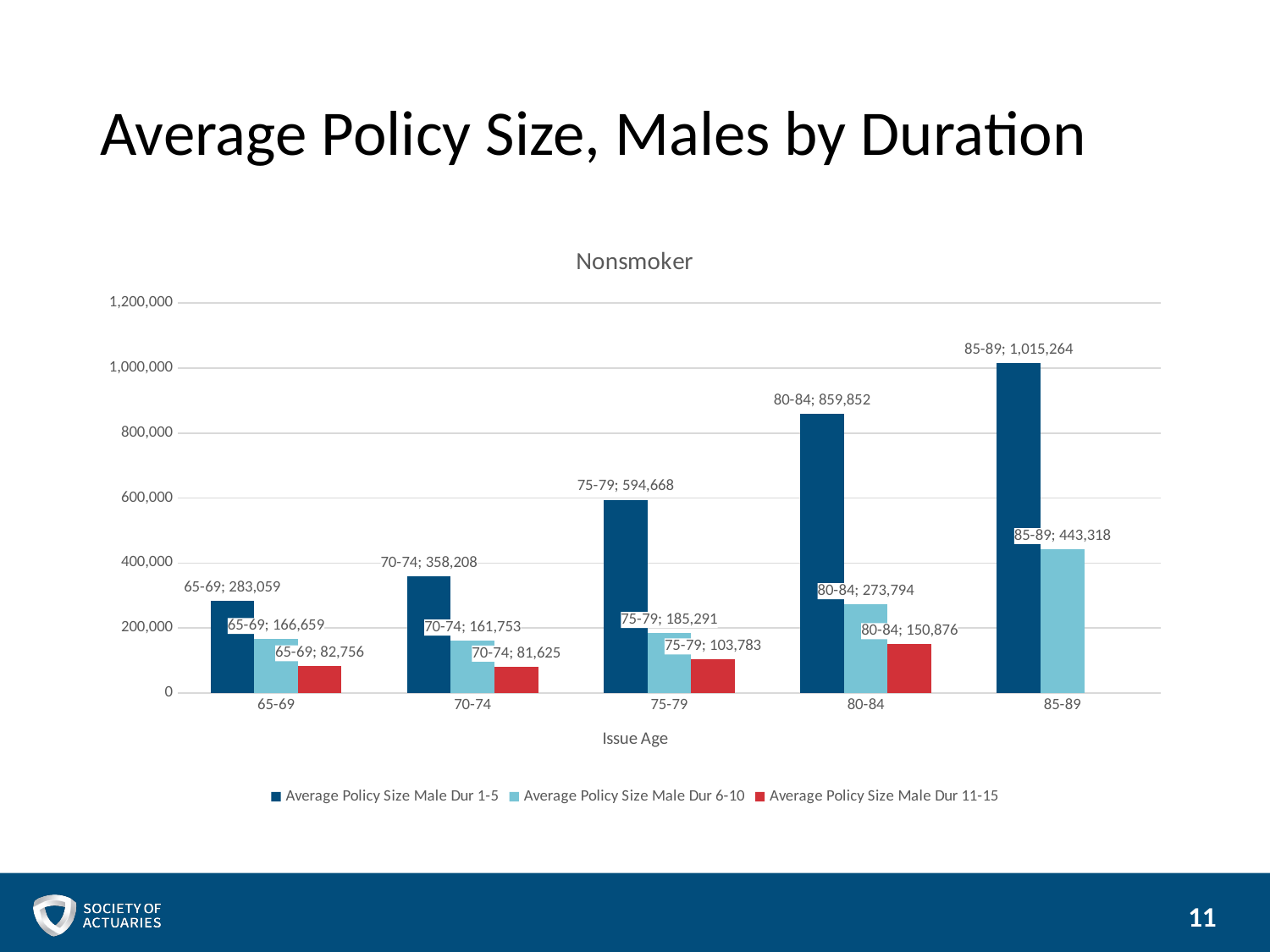
What kind of chart is shown on the slide? bar chart How many series does the legend list? 3 Which is larger for issue age 65-69: the Dur 1-5 value or the Dur 6-10 value? Dur 1-5 Is the Average Policy Size Male Dur 1-5 value for issue age 80-84 greater or less than 800,000? greater How many issue age categories are shown on the x axis? 5 Which issue age has the highest Average Policy Size Male Dur 1-5 value? 85-89 Do the Average Policy Size Male Dur 1-5 values rise or fall as issue age increases from 65-69 to 85-89? rise What is the Average Policy Size Male Dur 6-10 value for issue age 80-84? 273,794 What is the Average Policy Size Male Dur 1-5 value for issue age 85-89? 1,015,264 What is the Average Policy Size Male Dur 11-15 value for issue age 75-79? 103,783 Which issue age has the lowest Average Policy Size Male Dur 6-10 value? 70-74 What is the difference between the Average Policy Size Male Dur 1-5 values for issue ages 85-89 and 80-84? 155,412